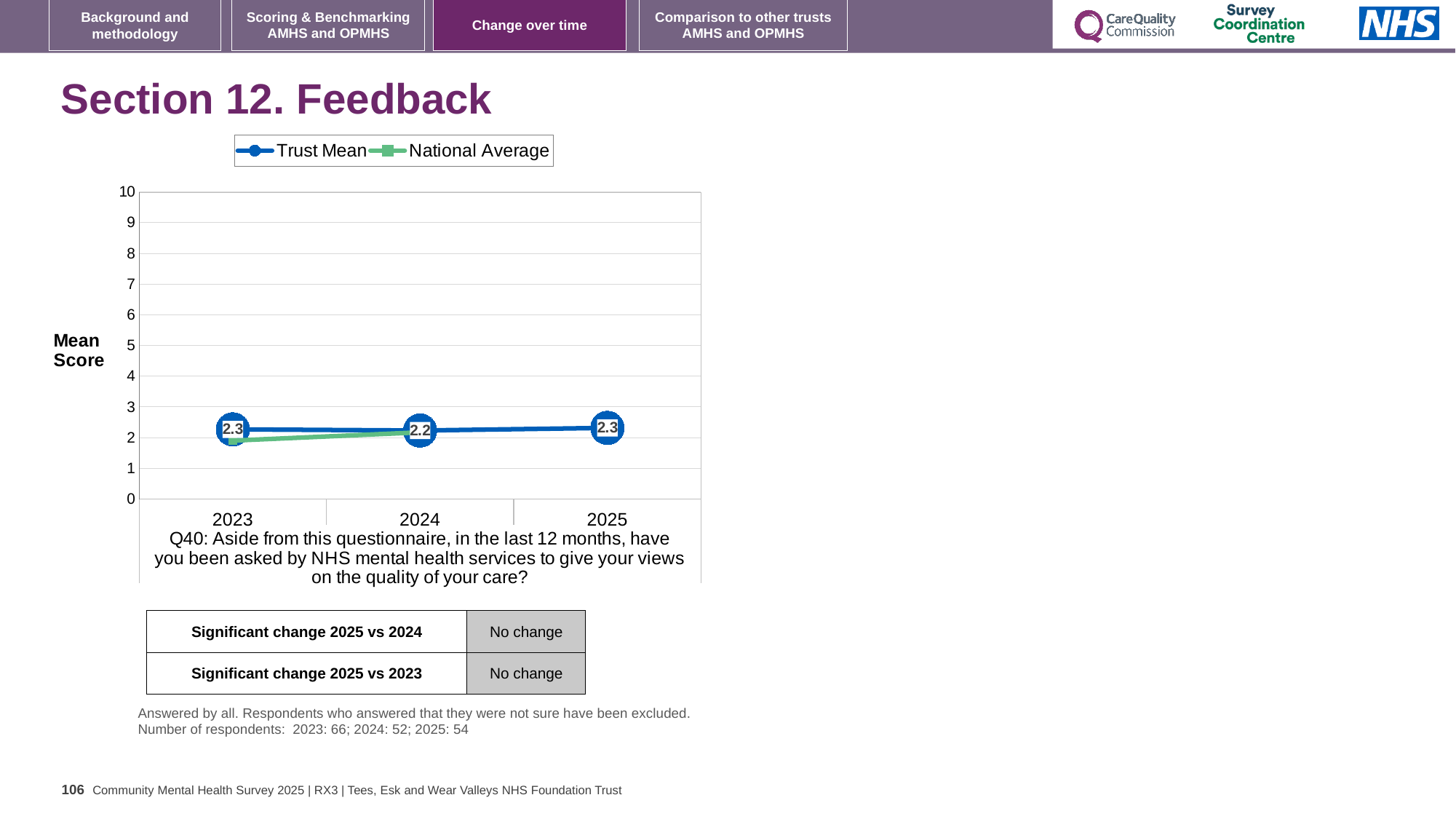
Is the National Average value for 2023 greater or less than 3? less In which year is the Trust Mean score lowest? 2024 How many years are plotted along the x axis? 3 What is the difference between the Trust Mean scores for 2023 and 2024? 0.1 In 2023, which is higher: the Trust Mean or the National Average? Trust Mean What is the label on the y axis of the chart? Mean Score What kind of chart is shown on the slide? Line chart How many series does the legend list? 2 Is the Trust Mean value for 2024 greater or less than 5? less What is the Trust Mean score for 2023? 2.3 What is the Trust Mean score for 2025? 2.3 What is the Trust Mean score for 2024? 2.2